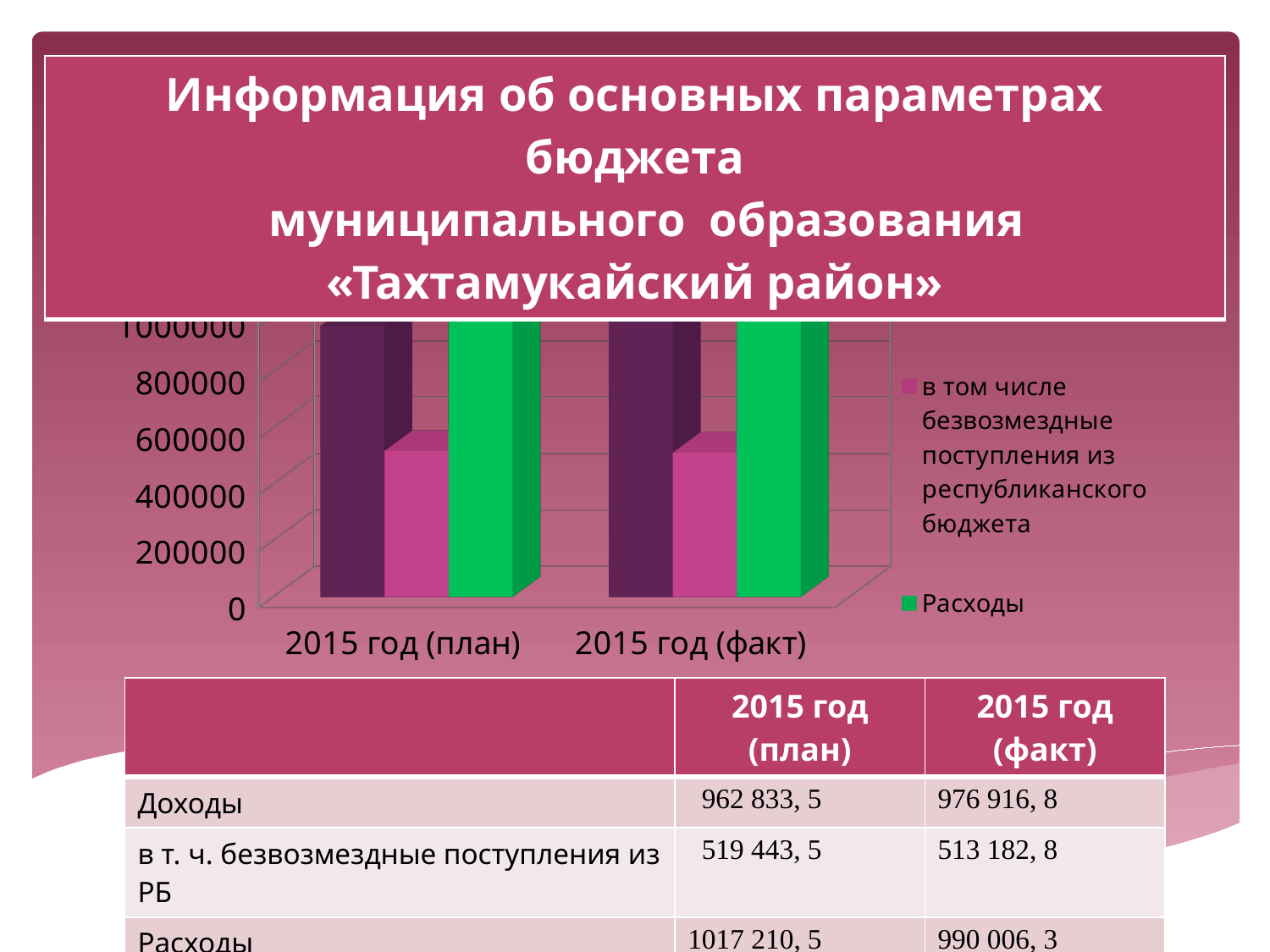
Is the value of the pink bar (безвозмездные поступления из республиканского бюджета) for 2015 год (план) greater or less than 400000? greater Is the value of the pink bar (безвозмездные поступления из республиканского бюджета) for 2015 год (факт) greater or less than 600000? less According to the table on the slide, what is the value of безвозмездные поступления из РБ for 2015 год (план)? 519 443, 5 What kind of chart is shown on the slide? bar chart How many bars are plotted for each category in the chart? 3 For 2015 год (план), which is larger: Расходы or безвозмездные поступления из республиканского бюджета? Расходы According to the table on the slide, what is the value of Расходы for 2015 год (план)? 1017 210, 5 Which colour represents Расходы in the chart legend? green According to the table on the slide, what is the value of Доходы for 2015 год (факт)? 976 916, 8 According to the table on the slide, is Доходы higher for 2015 год (план) or 2015 год (факт)? 2015 год (факт) How many categories are shown on the x axis of the chart? 2 What are the two category labels on the x axis of the chart? 2015 год (план) and 2015 год (факт)